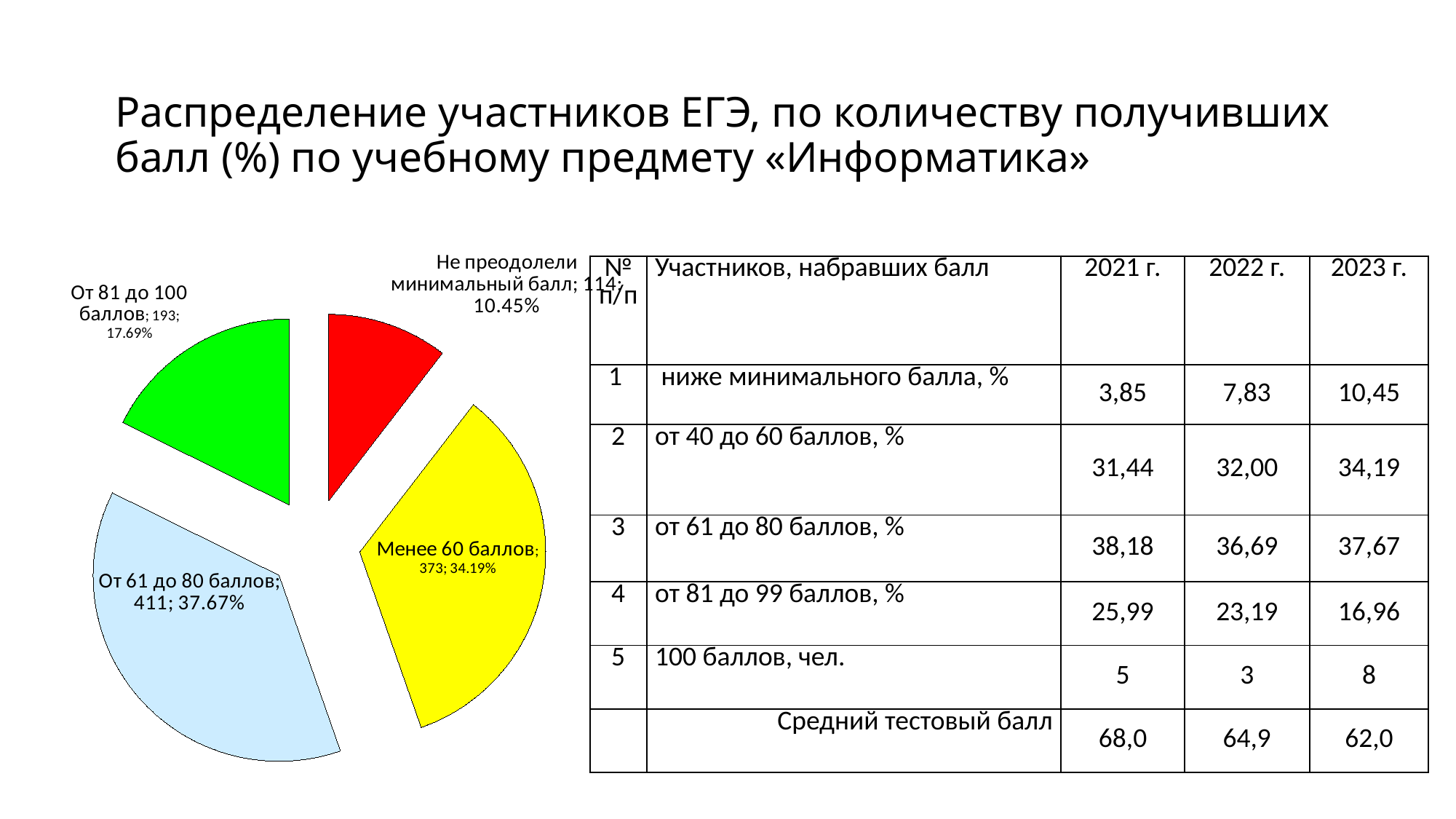
What colour is the "Не преодолели минимальный балл" slice in the pie chart? red In the pie chart, which has more participants: "Менее 60 баллов" or "От 81 до 100 баллов"? Менее 60 баллов In the pie chart, how many participants are shown for "От 81 до 100 баллов"? 193 In the pie chart, what is the difference in participants between "От 61 до 80 баллов" and "Менее 60 баллов"? 38 Which slice of the pie chart is the largest? От 61 до 80 баллов What kind of chart is shown on the left of the slide? pie chart In the pie chart, what percentage is shown for "От 61 до 80 баллов"? 37.67% In the pie chart, how many participants are shown for "Менее 60 баллов"? 373 Which slice of the pie chart is the smallest? Не преодолели минимальный балл In the pie chart, what percentage is shown for "Не преодолели минимальный балл"? 10.45% In the pie chart, what is the difference in participants between "От 81 до 100 баллов" and "Не преодолели минимальный балл"? 79 How many slices does the pie chart have? 4